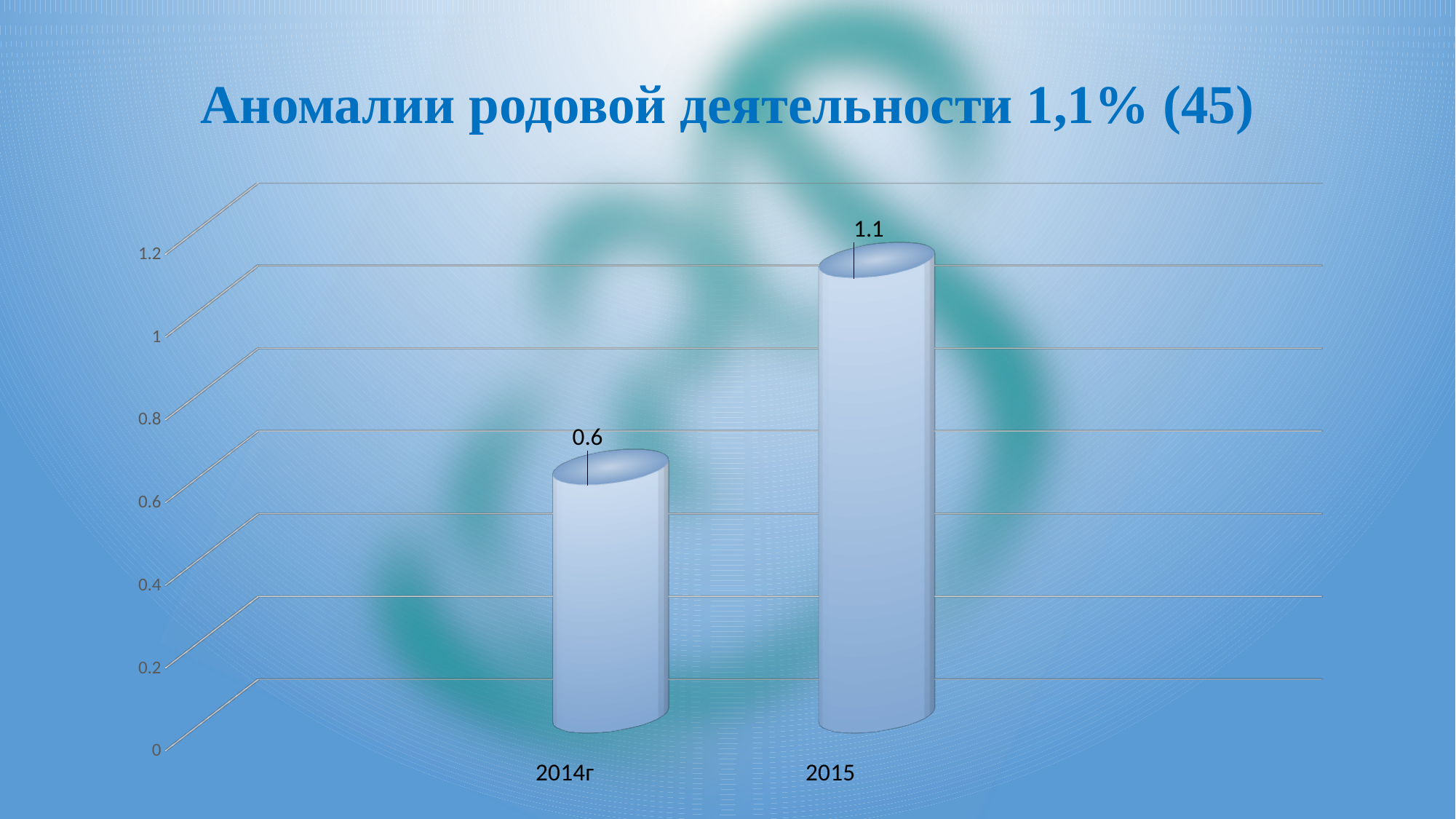
What is the value for 2014г? 0.6 Is the value for 2015 greater or less than 1? greater Which is larger, the value for 2014г or the value for 2015? 2015 How many categories are shown on the x axis? 2 What is the difference between the values for 2015 and 2014г? 0.5 What kind of chart is shown on the slide? bar chart Which category has the lowest value? 2014г Do the values rise or fall from 2014г to 2015? rise What is the value for 2015? 1.1 What is the title of the slide? Аномалии родовой деятельности 1,1% (45) Which category has the highest value? 2015 Is the value for 2014г greater or less than 0.8? less